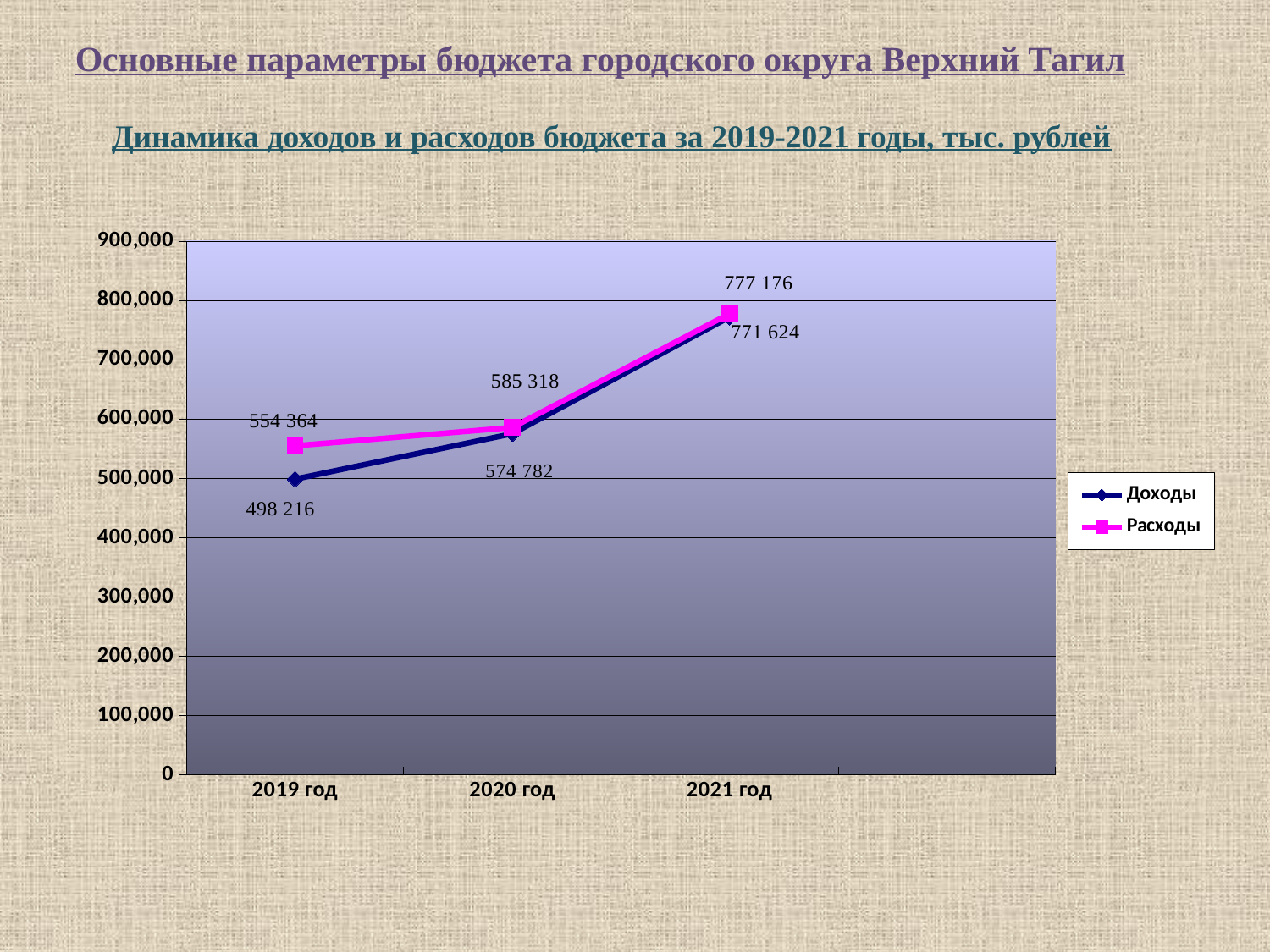
In which year is Расходы the lowest? 2019 год Which is larger in 2020 год, Доходы or Расходы? Расходы How many years are shown on the x axis? 3 What is the value of Расходы for 2021 год? 777 176 In which year is Доходы the highest? 2021 год What is the value of Доходы for 2019 год? 498 216 What is the value of Доходы for 2020 год? 574 782 Is the value of Доходы for 2019 год greater or less than 500,000? less What is the difference between Расходы and Доходы in 2019 год? 56 148 What is the value of Расходы for 2019 год? 554 364 How many series does the legend list? 2 What kind of chart is shown on the slide? line chart